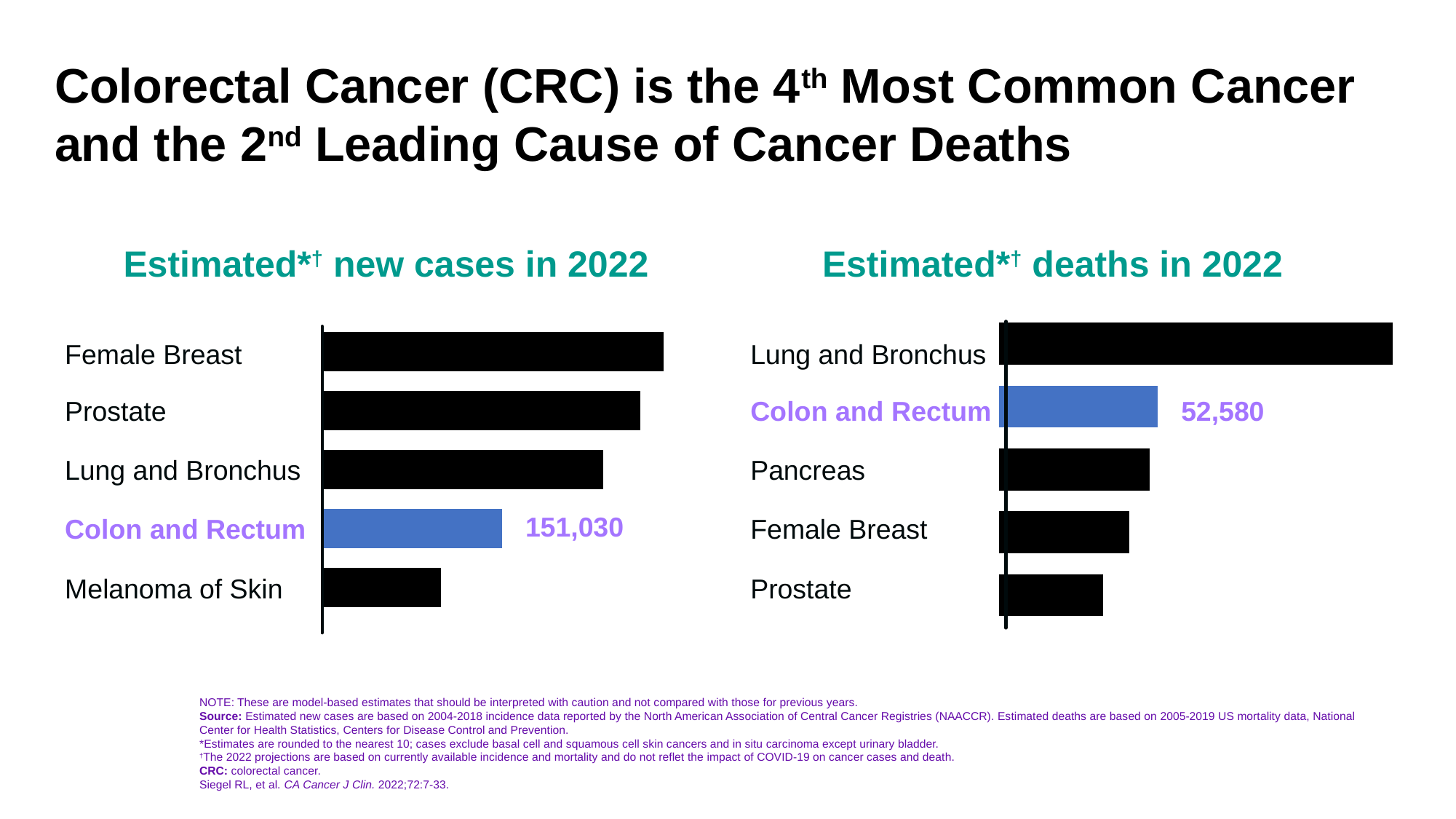
What type of chart is the 'Estimated deaths in 2022' chart? Bar chart In the 'Estimated new cases in 2022' chart, which category's bar is coloured blue instead of black? Colon and Rectum In the 'Estimated deaths in 2022' chart, which category has the lowest value? Prostate In the 'Estimated new cases in 2022' chart, which category has the lowest value? Melanoma of Skin In the 'Estimated deaths in 2022' chart, which category has the highest value? Lung and Bronchus How many categories are shown in the 'Estimated deaths in 2022' chart? 5 In the 'Estimated deaths in 2022' chart, which is larger, Pancreas or Prostate? Pancreas In the 'Estimated deaths in 2022' chart, what is the value for Colon and Rectum? 52,580 In the 'Estimated new cases in 2022' chart, what is the value for Colon and Rectum? 151,030 How many categories are shown in the 'Estimated new cases in 2022' chart? 5 In the 'Estimated new cases in 2022' chart, which category has the highest value? Female Breast In the 'Estimated new cases in 2022' chart, which is larger, Prostate or Lung and Bronchus? Prostate